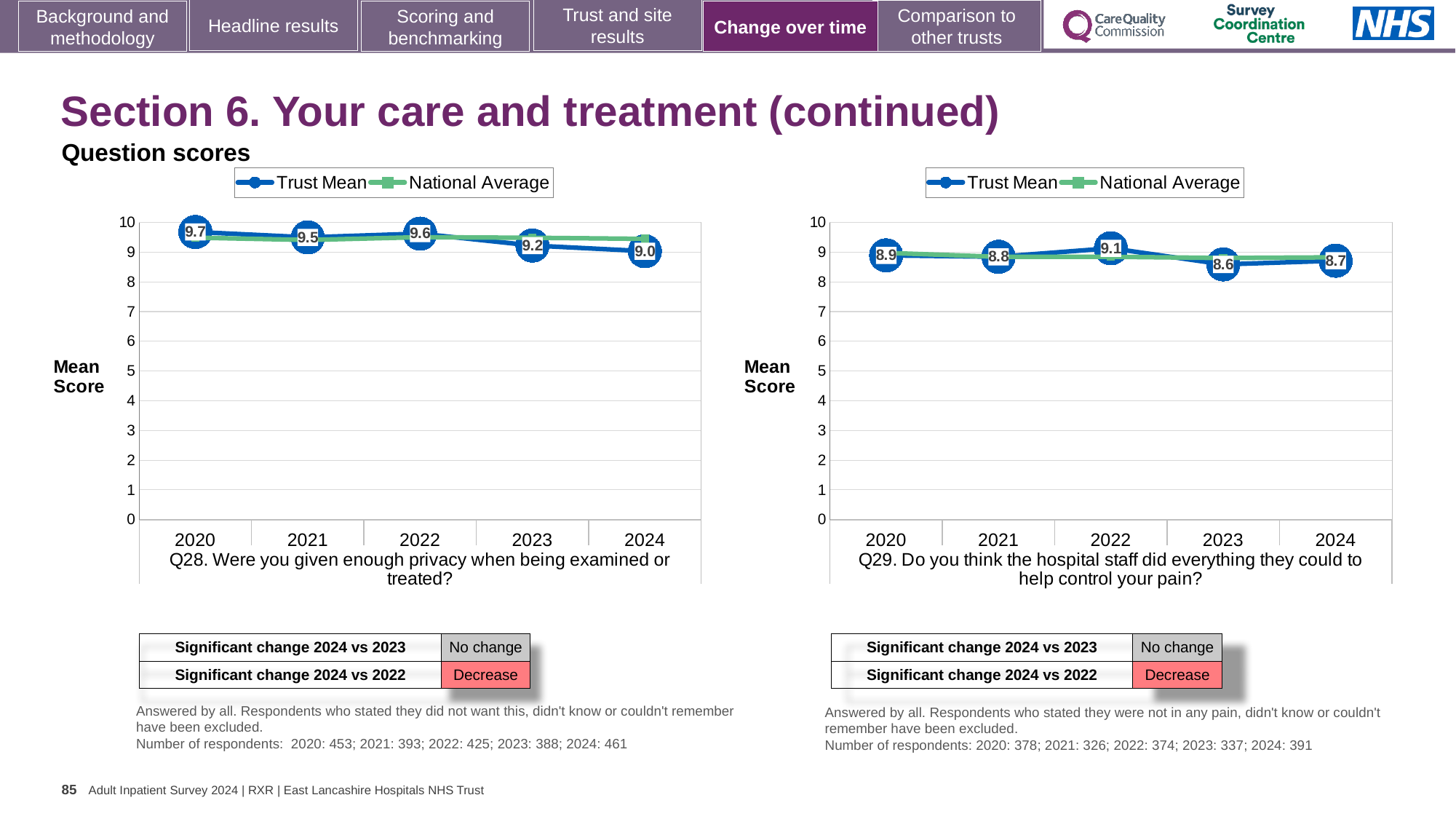
In the Q28 chart (left), what is the difference between the Trust Mean for 2020 and 2024? 0.7 What type of chart is the Q29 chart (right)? line chart In the Q29 chart (right), which year has the highest Trust Mean? 2022 In the Q28 chart (left), what is the Trust Mean for 2020? 9.7 In the Q28 chart (left), what is the Trust Mean for 2024? 9.0 In the Q29 chart (right), what is the Trust Mean for 2022? 9.1 In the Q28 chart (left), which year has the lowest Trust Mean? 2024 In the Q29 chart (right), is the Trust Mean for 2023 greater or less than 9? less In the Q28 chart (left), how many series does the legend list? 2 In the Q29 chart (right), which year has the lowest Trust Mean? 2023 In the Q28 chart (left), does the Trust Mean generally rise or fall from 2020 to 2024? fall In the Q29 chart (right), how many years are plotted on the x axis? 5